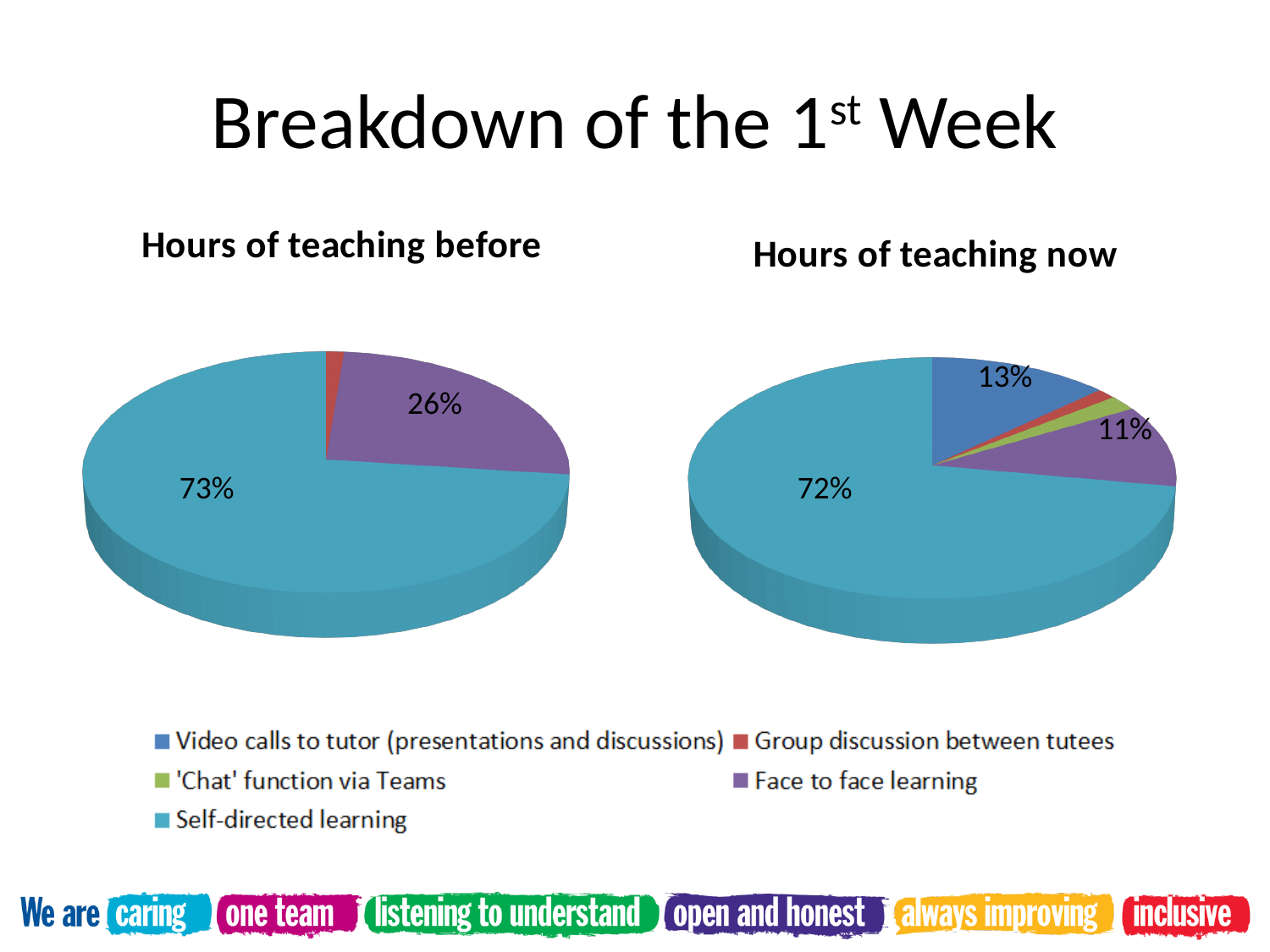
In the 'Hours of teaching before' chart, which category has the largest slice? Self-directed learning In the 'Hours of teaching now' chart, what share is Self-directed learning? 72% What kind of chart is used for 'Hours of teaching before'? Pie chart How many categories does the shared legend list? 5 In the 'Hours of teaching now' chart, which category has the largest slice? Self-directed learning In the 'Hours of teaching now' chart, what share is Face to face learning? 11% In the 'Hours of teaching before' chart, what share is Self-directed learning? 73% In the 'Hours of teaching now' chart, what share is Video calls to tutor (presentations and discussions)? 13% In the 'Hours of teaching now' chart, what is the difference between the Video calls to tutor share and the Face to face learning share? 2% In the 'Hours of teaching now' chart, which is larger: Video calls to tutor or Face to face learning? Video calls to tutor In the 'Hours of teaching before' chart, what share is Face to face learning? 26% In the 'Hours of teaching before' chart, what is the difference between the Self-directed learning and Face to face learning shares? 47%